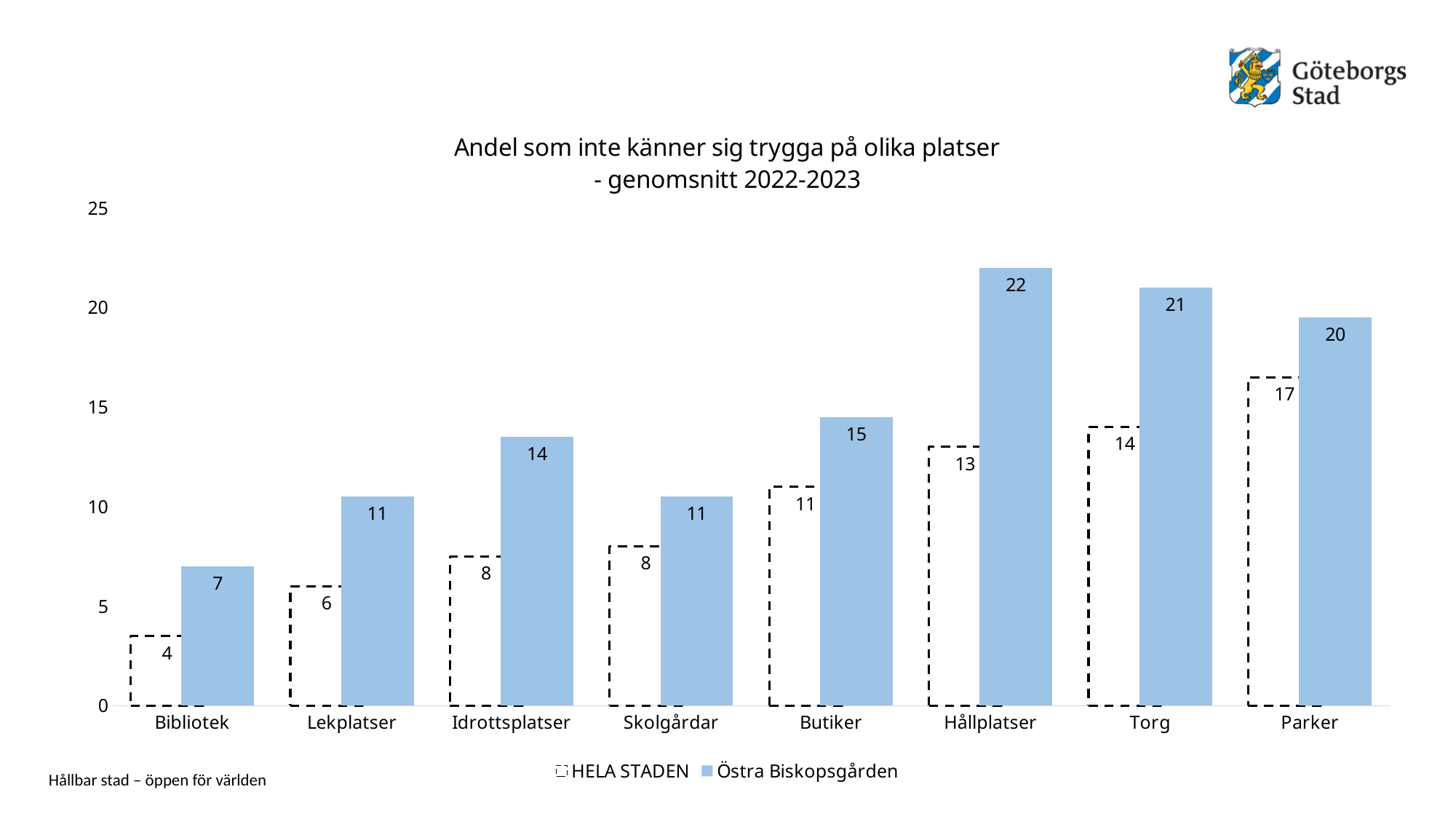
What is the title of the chart? Andel som inte känner sig trygga på olika platser - genomsnitt 2022-2023 How many categories are shown on the x axis? 8 What kind of chart is shown on the slide? bar chart Which category has the highest value for Östra Biskopsgården? Hållplatser Which category has the lowest value for HELA STADEN? Bibliotek Is the value for Östra Biskopsgården at Idrottsplatser greater or less than 10? greater What is the value for HELA STADEN at Bibliotek? 4 What is the value for Östra Biskopsgården at Hållplatser? 22 How many series does the legend list? 2 Which is larger at Butiker: the value for HELA STADEN or for Östra Biskopsgården? Östra Biskopsgården What is the value for HELA STADEN at Parker? 17 What is the difference between Östra Biskopsgården and HELA STADEN at Torg? 7